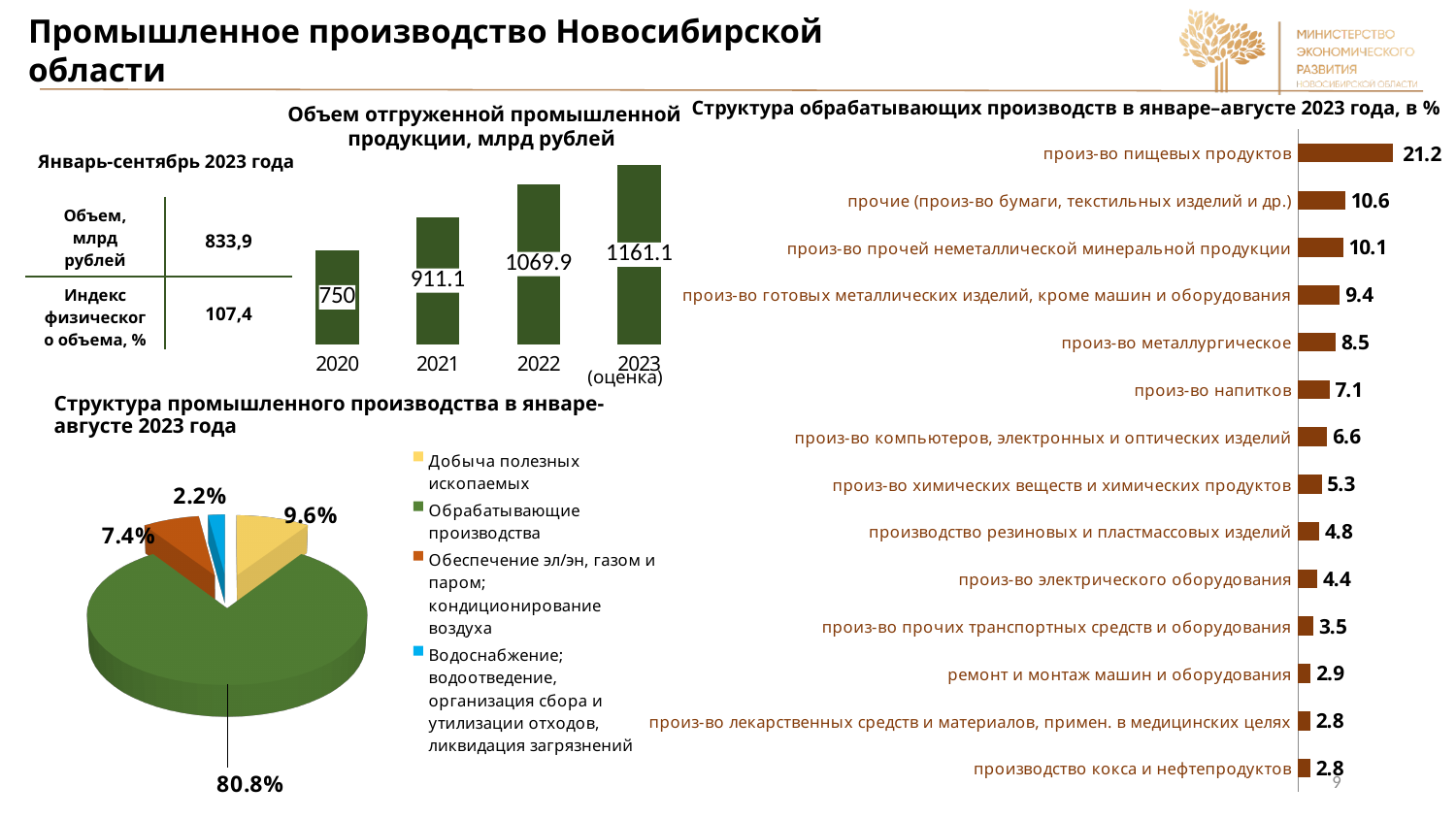
How many categories does the legend of the pie chart 'Структура промышленного производства в январе-августе 2023 года' list? 4 In the chart 'Объем отгруженной промышленной продукции, млрд рублей', do the values rise or fall from 2020 to 2023? rise In the chart 'Структура обрабатывающих производств в январе–августе 2023 года, в %', which category has the highest value? произ-во пищевых продуктов In the chart 'Структура обрабатывающих производств в январе–августе 2023 года, в %', which is larger: 'произ-во напитков' or 'произ-во химических веществ и химических продуктов'? произ-во напитков How many bars are in the chart 'Объем отгруженной промышленной продукции, млрд рублей'? 4 In the chart 'Объем отгруженной промышленной продукции, млрд рублей', what is the difference between the 2022 and 2020 values? 319.9 In the chart 'Объем отгруженной промышленной продукции, млрд рублей', what is the value for 2021? 911.1 In the pie chart 'Структура промышленного производства в январе-августе 2023 года', what share does 'Обрабатывающие производства' have? 80.8% In the chart 'Структура обрабатывающих производств в январе–августе 2023 года, в %', what is the value for 'произ-во металлургическое'? 8.5 In the pie chart 'Структура промышленного производства в январе-августе 2023 года', which category has the smallest slice? Водоснабжение; водоотведение, организация сбора и утилизации отходов, ликвидация загрязнений In the chart 'Объем отгруженной промышленной продукции, млрд рублей', what is the value for 2023 (оценка)? 1161.1 What type of chart is 'Структура обрабатывающих производств в январе–августе 2023 года, в %'? bar chart